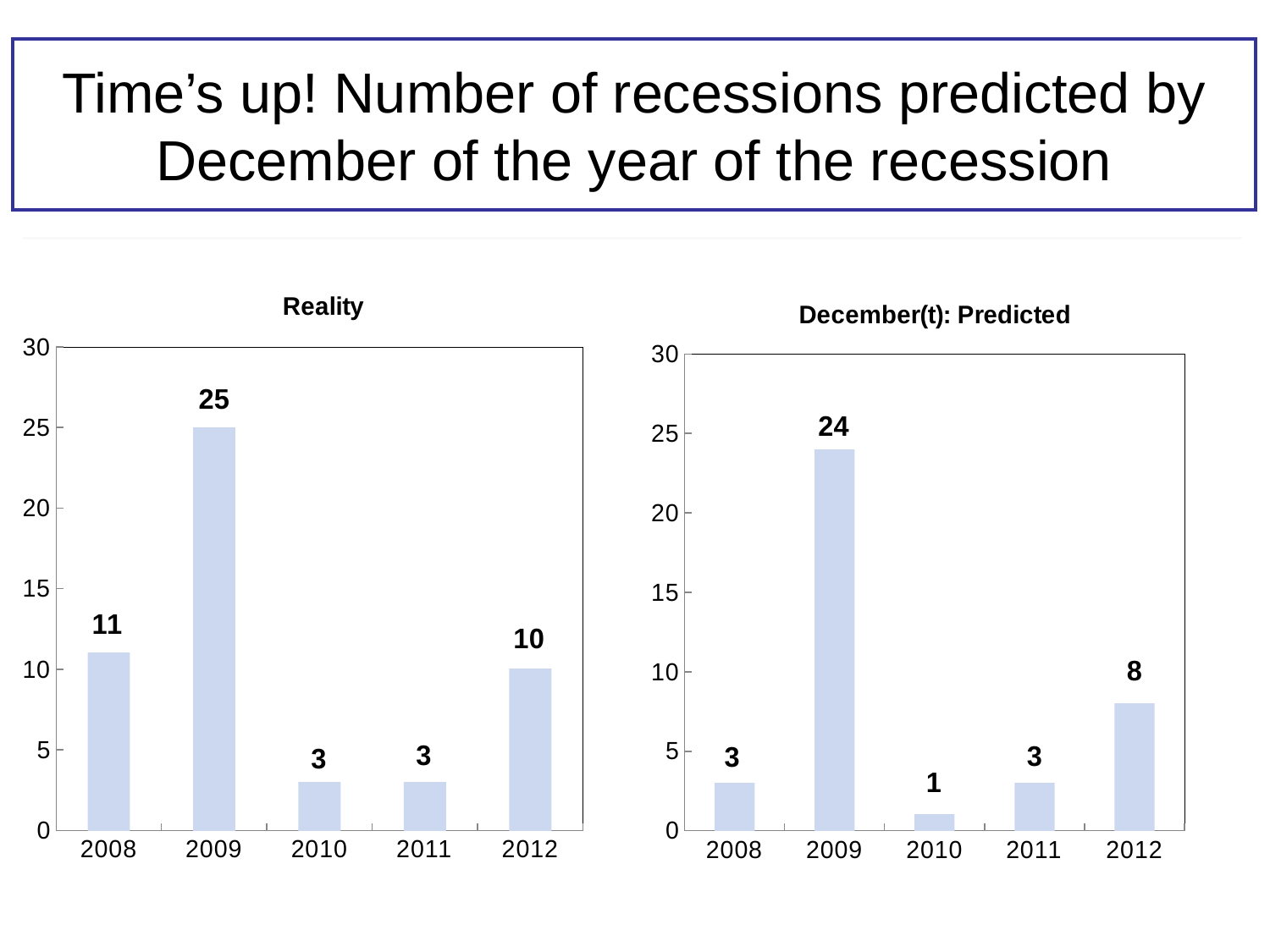
How many years are shown on the x axis of the 'Reality' chart? 5 In the 'Reality' chart, what is the difference between the values for 2009 and 2012? 15 In the 'December(t): Predicted' chart, what is the value for 2012? 8 In the 'Reality' chart, what is the value for 2009? 25 In the 'Reality' chart, which year has the highest value? 2009 In the 'December(t): Predicted' chart, which year has the lowest value? 2010 What is the difference between the 2008 value in the 'Reality' chart and the 2008 value in the 'December(t): Predicted' chart? 8 What is the title of the chart on the left side of the slide? Reality What kind of chart is the 'December(t): Predicted' chart? bar chart In the 'Reality' chart, is the value for 2012 greater or less than 5? greater In the 'December(t): Predicted' chart, what is the value for 2010? 1 In the 'December(t): Predicted' chart, which is larger, the value for 2008 or the value for 2012? 2012